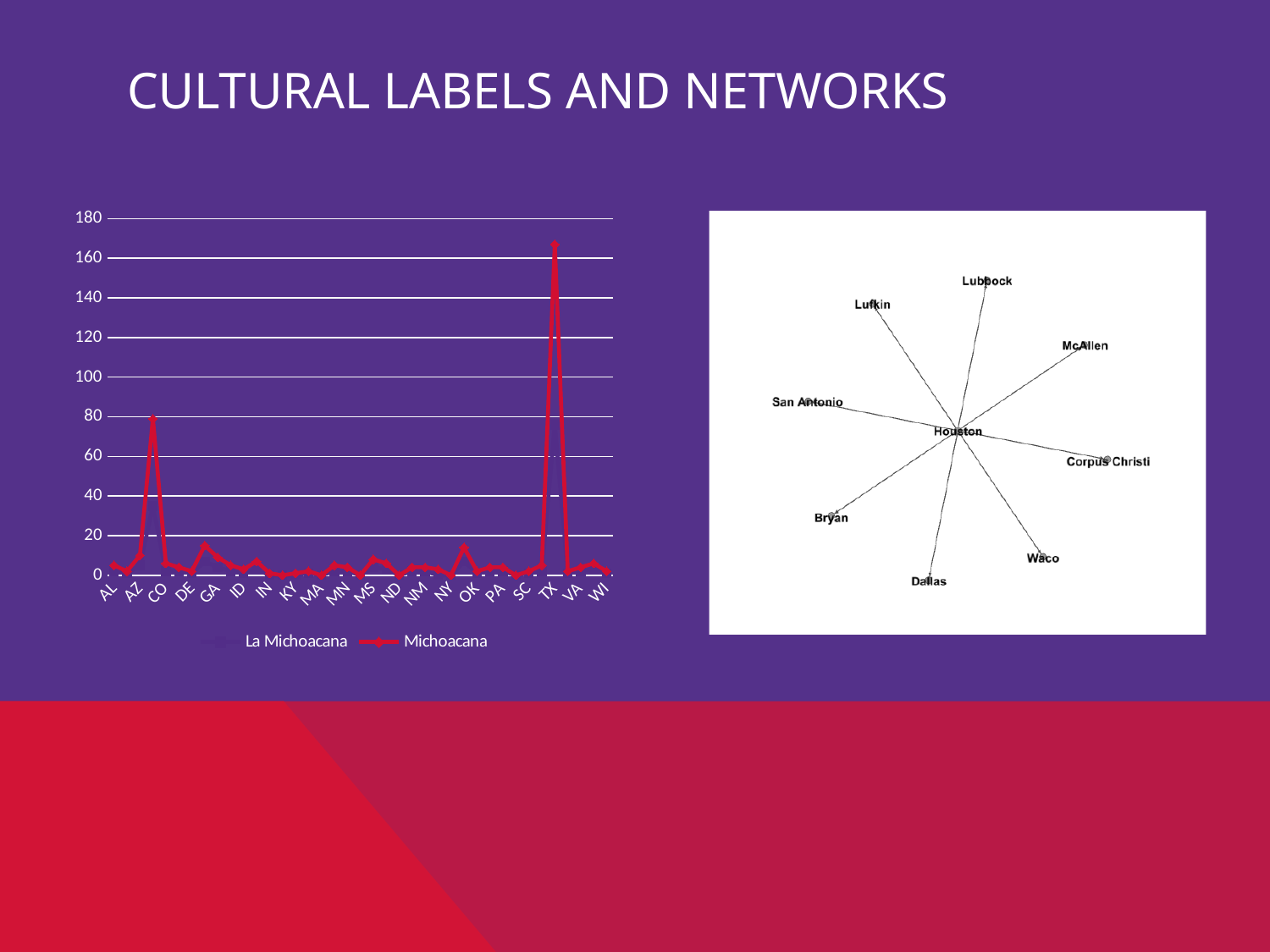
In the left chart, which has the larger Michoacana value, WI or TX? TX In the left chart, is the Michoacana value for NY greater or less than 40? less In the left chart, is the Michoacana value for AL greater or less than 20? less In the left chart, which state has the highest value for the Michoacana series? TX What are the two series names listed in the legend of the left chart? La Michoacana and Michoacana In the left chart, which has the larger Michoacana value, TX or AL? TX What kind of chart is the chart on the left of the slide? line chart What is the highest value shown on the y axis of the left chart? 180 How many series does the legend of the left chart list? 2